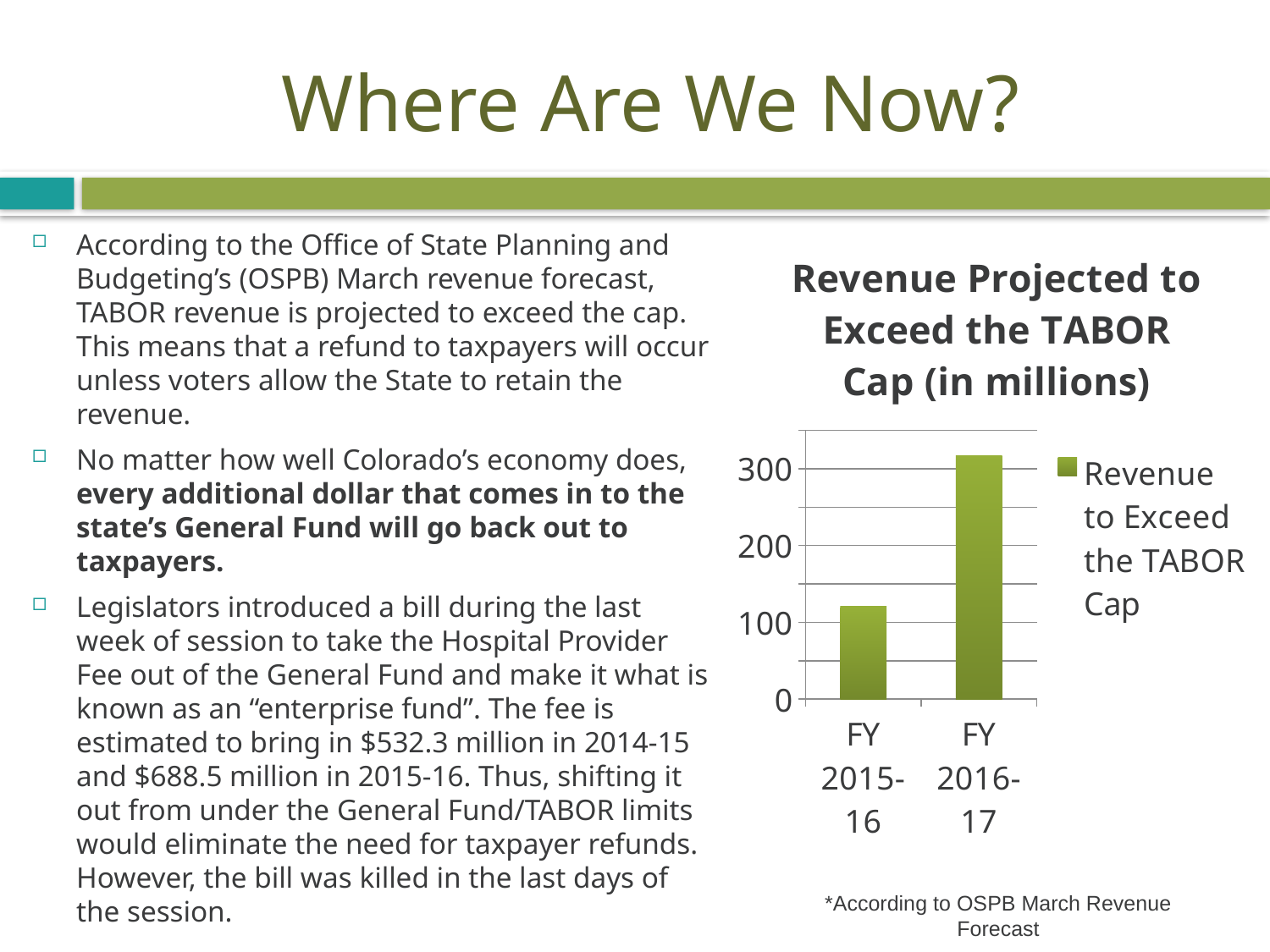
Which is larger, the value for FY 2015-16 or the value for FY 2016-17? FY 2016-17 What is the title of the chart? Revenue Projected to Exceed the TABOR Cap (in millions) What kind of chart is shown on the slide? bar chart Is the value for FY 2016-17 greater or less than 300? greater Do the values rise or fall from FY 2015-16 to FY 2016-17? rise Which fiscal year has the highest projected revenue to exceed the TABOR cap? FY 2016-17 Is the value for FY 2015-16 greater or less than 100? greater Is the value for FY 2015-16 greater or less than 200? less How many categories are plotted on the x axis of the chart? 2 Which fiscal year has the lowest projected revenue to exceed the TABOR cap? FY 2015-16 How many series does the chart's legend list? 1 What is the name of the series listed in the chart's legend? Revenue to Exceed the TABOR Cap